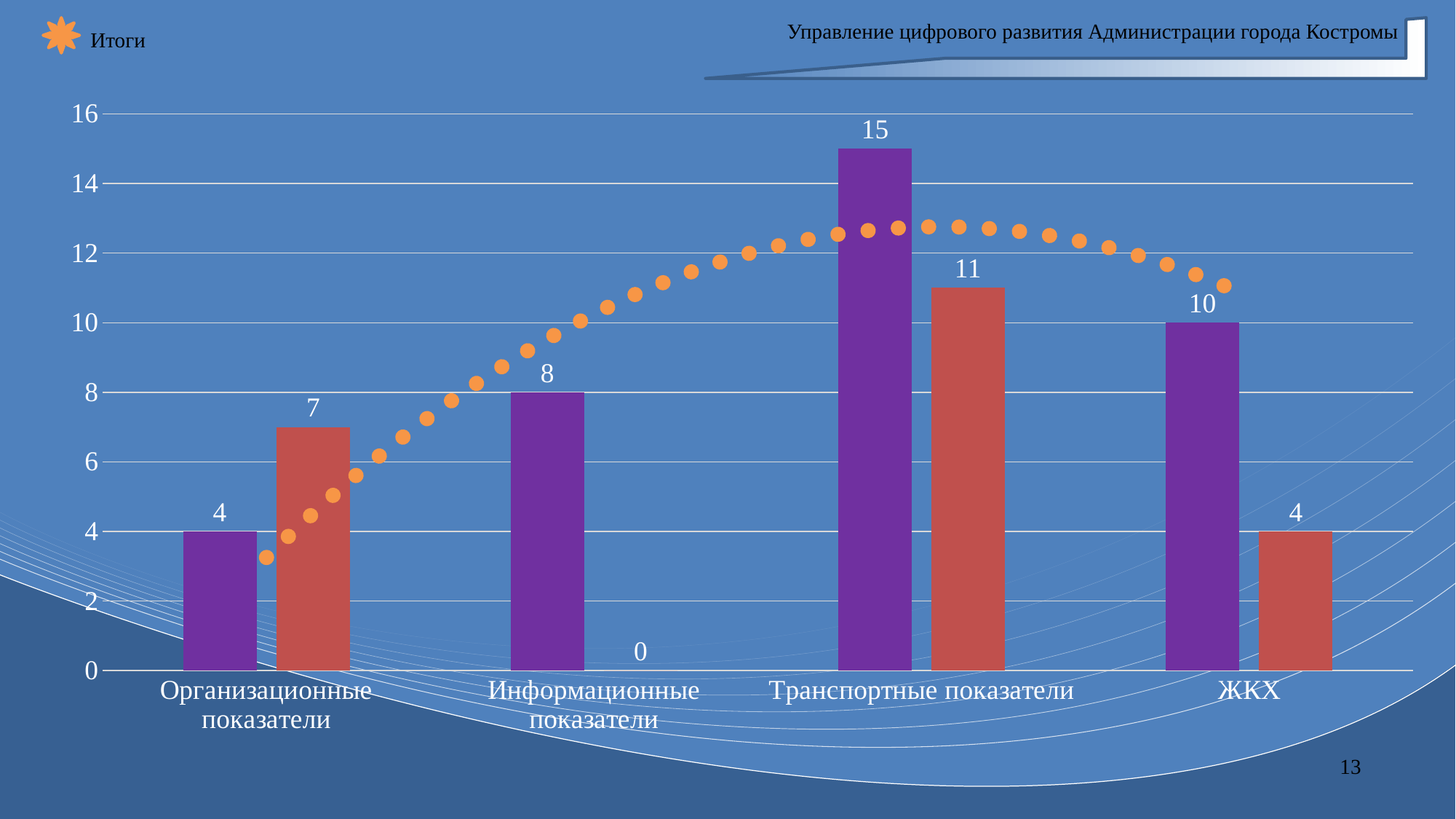
What colour is the dotted line overlaid on the bars? orange What is the total of the purple and red bars for ЖКХ? 14 What is the difference between the purple and red bars for Транспортные показатели? 4 Which category has the highest purple bar? Транспортные показатели Which is larger for Организационные показатели, the purple bar or the red bar? the red bar What kind of chart is shown on the slide? bar chart What is the value of the purple bar for Транспортные показатели? 15 Which category has the lowest red bar? Информационные показатели What is the value of the red bar for Организационные показатели? 7 What is the value of the red bar for Информационные показатели? 0 What is the value of the purple bar for ЖКХ? 10 How many categories are shown on the x axis? 4